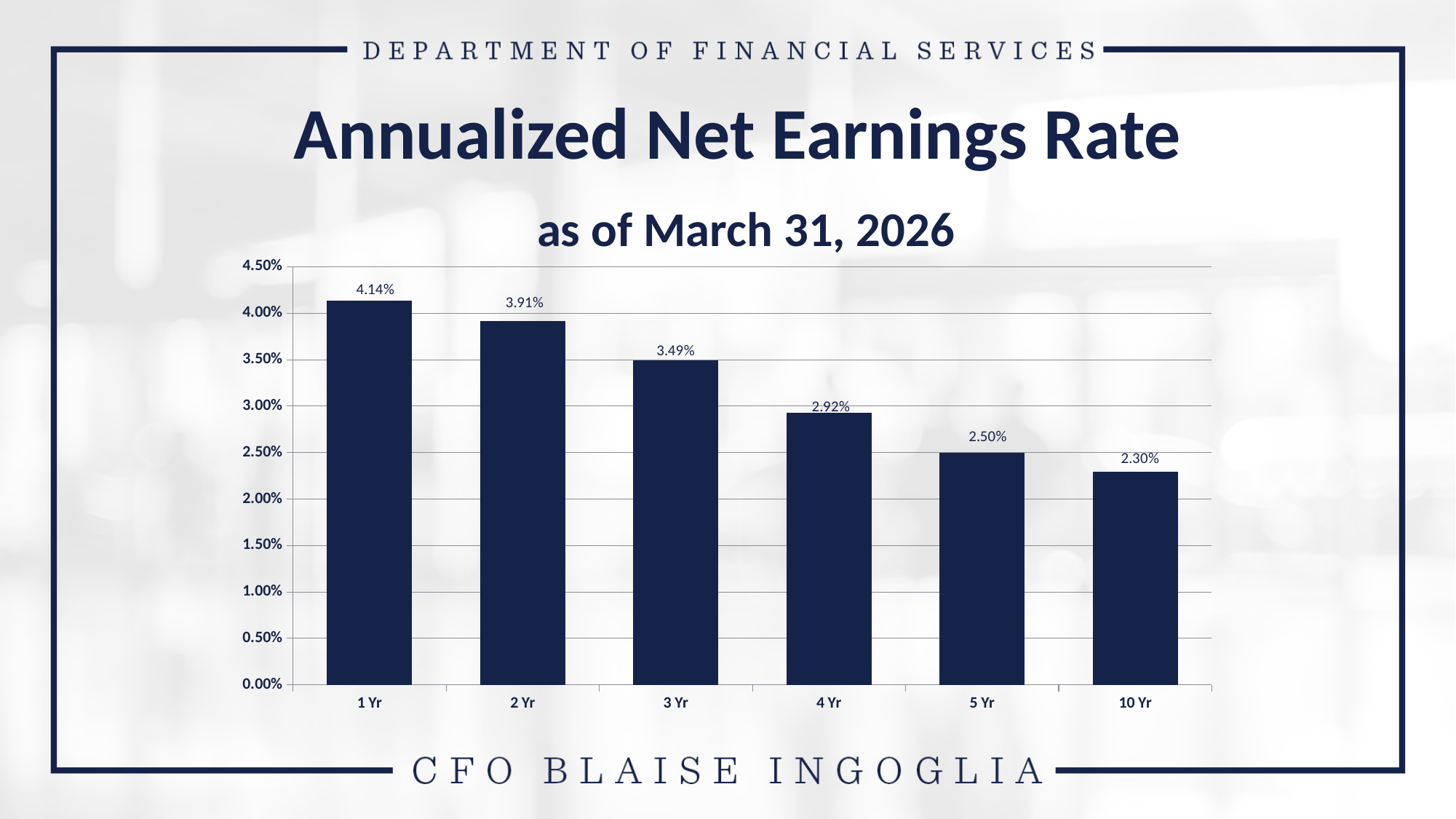
Do the values rise or fall moving from 1 Yr to 10 Yr along the x axis? Fall Is the value for 4 Yr greater or less than 3.00%? less What is the difference between the 1 Yr and 5 Yr annualized net earnings rates? 1.64% Which period has the lowest annualized net earnings rate? 10 Yr What is the annualized net earnings rate for 1 Yr? 4.14% What kind of chart is shown on the slide? Bar chart What is the difference between the 2 Yr and 4 Yr annualized net earnings rates? 0.99% Which period has the highest annualized net earnings rate? 1 Yr What is the annualized net earnings rate for 10 Yr? 2.30% How many periods are shown on the x axis? 6 What is the annualized net earnings rate for 3 Yr? 3.49% Which is larger, the 2 Yr rate or the 3 Yr rate? 2 Yr